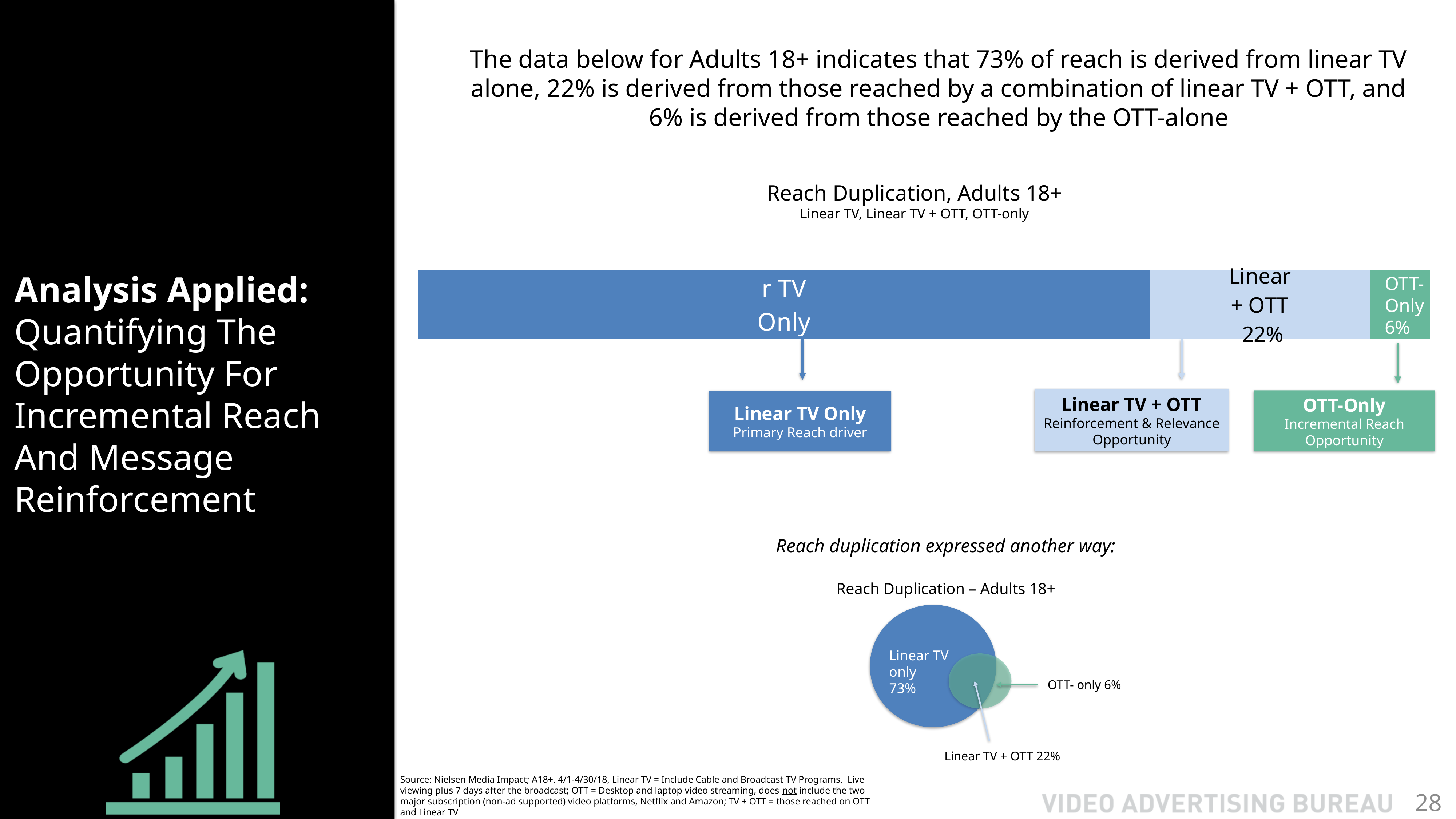
In the Reach Duplication, Adults 18+ bar chart, which segment is the smallest? OTT-Only In the Reach Duplication, Adults 18+ bar chart, what is the difference between the Linear TV + OTT and OTT-Only percentages? 16% In the Reach Duplication, Adults 18+ bar chart, which segment is the largest? Linear TV Only What is the subtitle printed under the title Reach Duplication, Adults 18+ on the bar chart? Linear TV, Linear TV + OTT, OTT-only In the Reach Duplication, Adults 18+ bar chart, what percentage is shown for the Linear TV + OTT segment? 22% How many segments make up the Reach Duplication, Adults 18+ stacked bar? 3 In the Reach Duplication, Adults 18+ bar chart, what colour is the OTT-Only segment? Green In the Reach Duplication, Adults 18+ bar chart, what percentage is shown for the OTT-Only segment? 6% In the Reach Duplication – Adults 18+ circle diagram at the bottom, what percentage is labelled for Linear TV + OTT? 22% What kind of chart is the Reach Duplication, Adults 18+ chart at the top of the slide? Stacked bar chart In the Reach Duplication – Adults 18+ circle diagram at the bottom, what percentage is labelled for Linear TV only? 73% In the Reach Duplication, Adults 18+ bar chart, which is larger: Linear TV + OTT or OTT-Only? Linear TV + OTT